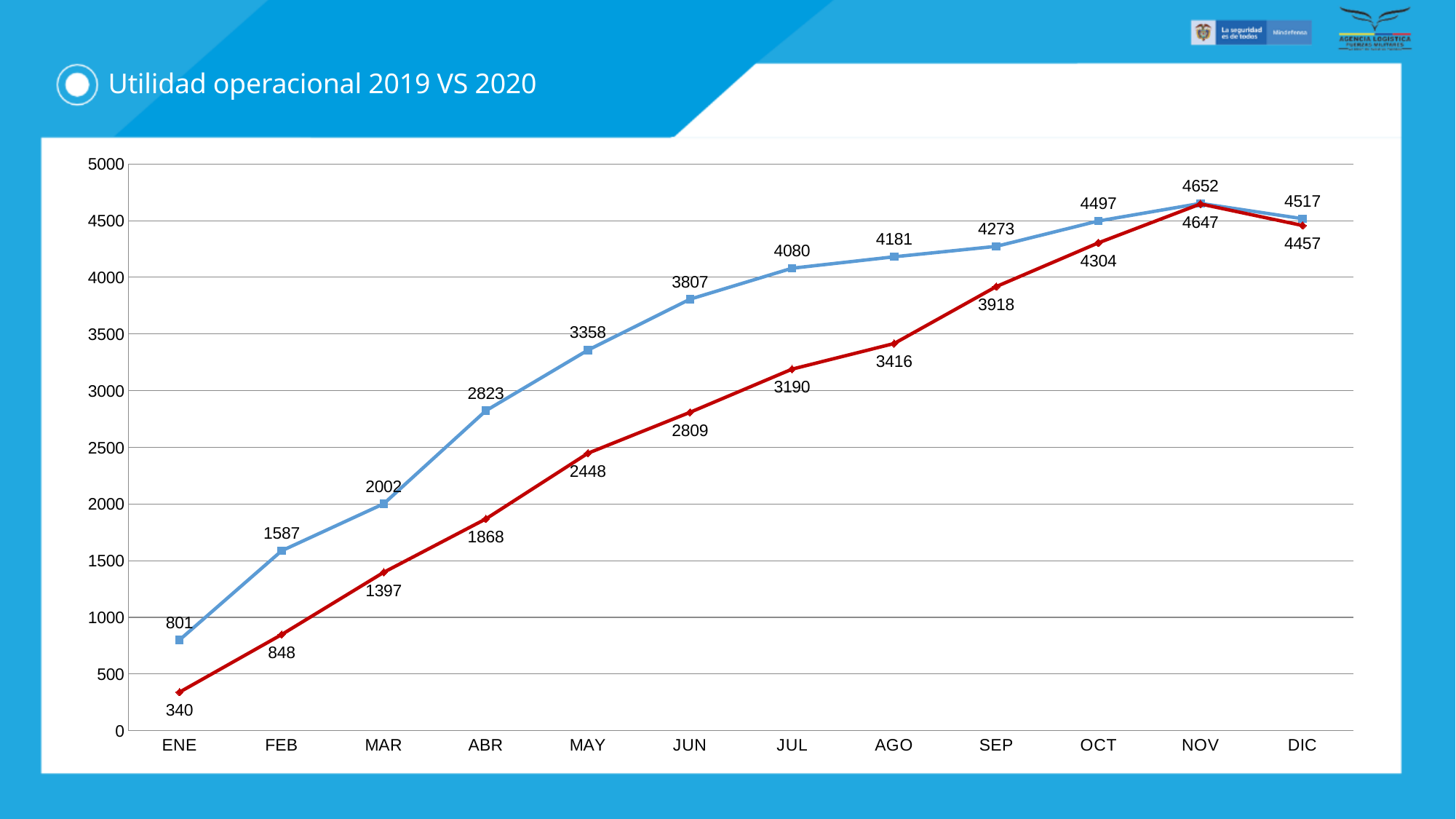
In which month does the blue line reach its highest value? NOV What is the difference between the blue line and the red line in MAY? 910 What is the value of the red line for ENE? 340 What is the title of the chart on the slide? Utilidad operacional 2019 VS 2020 Which is larger in ABR, the blue line value or the red line value? blue line In which month does the red line have its lowest value? ENE What is the value of the blue line for JUN? 3807 What is the value of the red line for SEP? 3918 What is the difference between the blue line's NOV value and its DIC value? 135 Is the red line's value for JUL greater or less than 3000? greater What kind of chart is shown on the slide? line chart How many months are shown on the x axis? 12